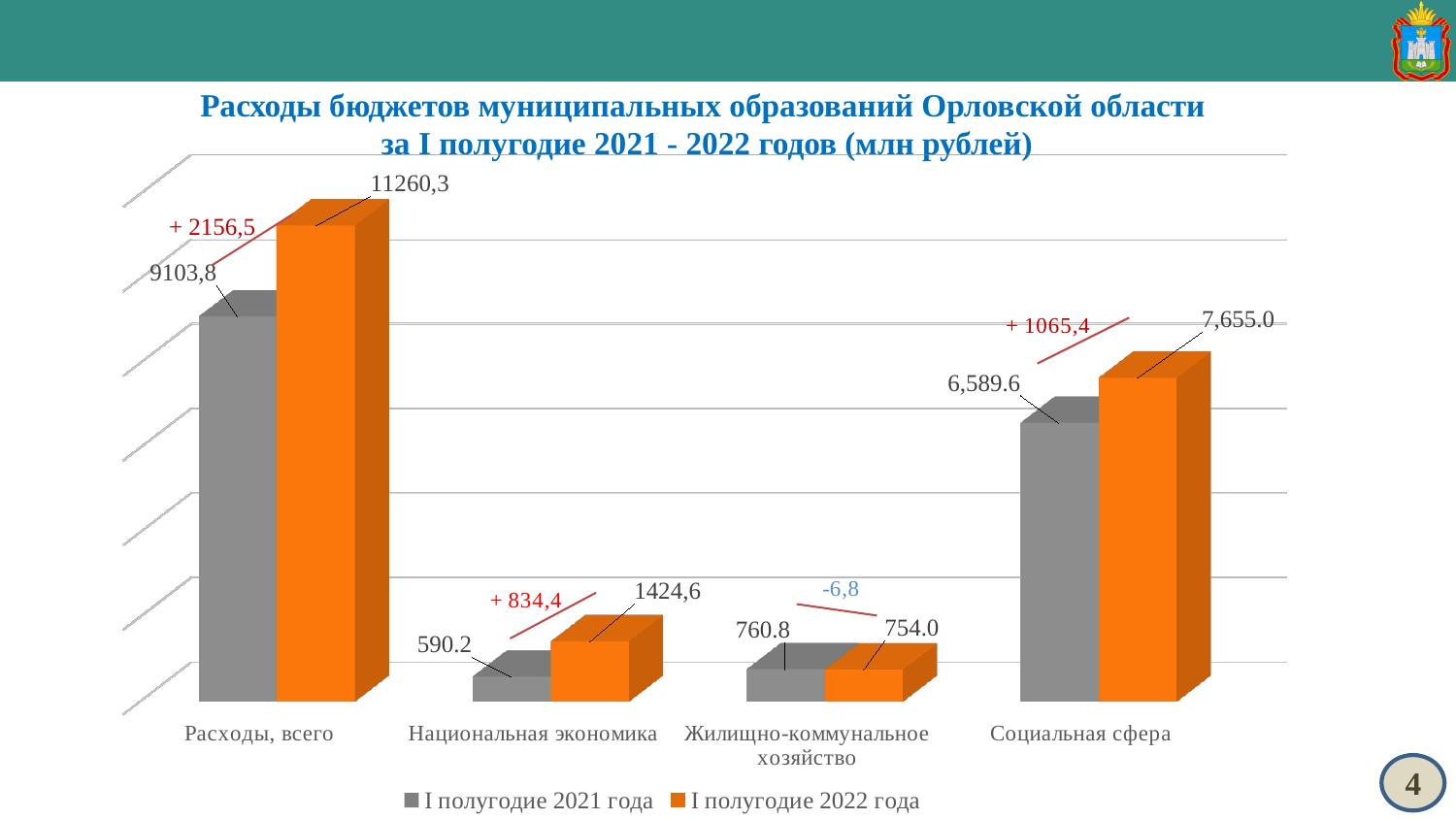
What is the value for Социальная сфера in I полугодие 2022 года? 7,655.0 Which category has the lowest value in I полугодие 2021 года? Национальная экономика What is the change shown between 2021 and 2022 for Жилищно-коммунальное хозяйство? -6,8 How many categories are shown on the x axis? 4 Which is larger for Социальная сфера: the value for I полугодие 2021 года or I полугодие 2022 года? I полугодие 2022 года What is the value for Расходы, всего in I полугодие 2021 года? 9103,8 What is the value for Национальная экономика in I полугодие 2021 года? 590.2 Which category has the highest value in I полугодие 2022 года? Расходы, всего What is the change shown between 2021 and 2022 for Национальная экономика? + 834,4 How many series does the legend list? 2 What is the value for Жилищно-коммунальное хозяйство in I полугодие 2022 года? 754.0 What is the value for Расходы, всего in I полугодие 2022 года? 11260,3